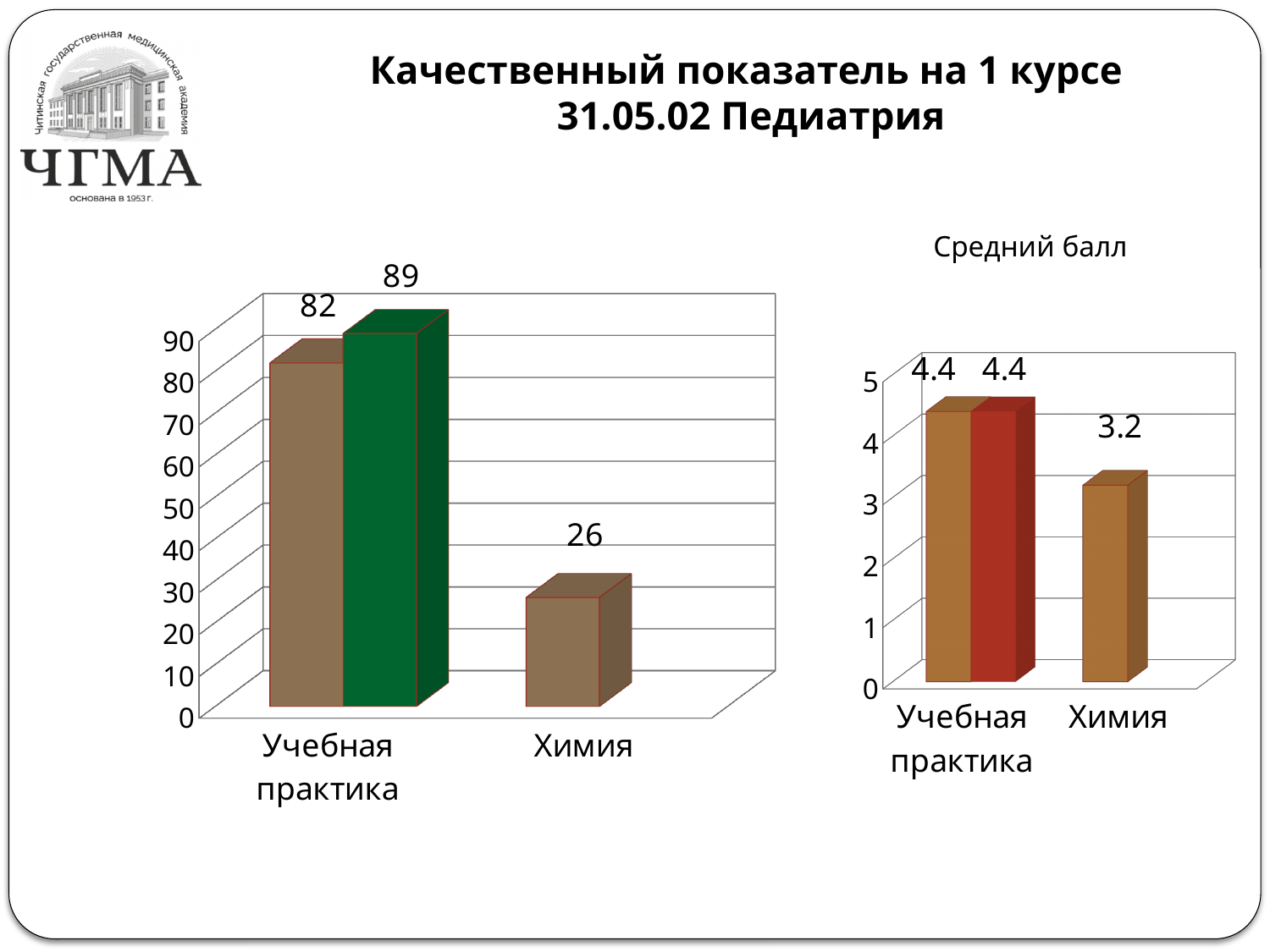
On the left chart, what is the difference between the brown bar for Учебная практика and the bar for Химия? 56 On the left chart, what is the difference between the green bar (89) and the brown bar (82) for Учебная практика? 7 On the chart titled Средний балл, what is the value of the red bar for Учебная практика? 4.4 On the left chart, what is the value for Химия? 26 What is the title of the chart on the right side of the slide? Средний балл On the left chart, how many bars are plotted in total? 3 On the left chart, what is the value of the brown bar for Учебная практика? 82 On the left chart, what is the value of the green bar for Учебная практика? 89 On the chart titled Средний балл, which is larger: the value for Учебная практика or the value for Химия? Учебная практика On the left chart, which category has the lowest value? Химия What kind of chart is the left chart? bar chart On the chart titled Средний балл, what is the value for Химия? 3.2